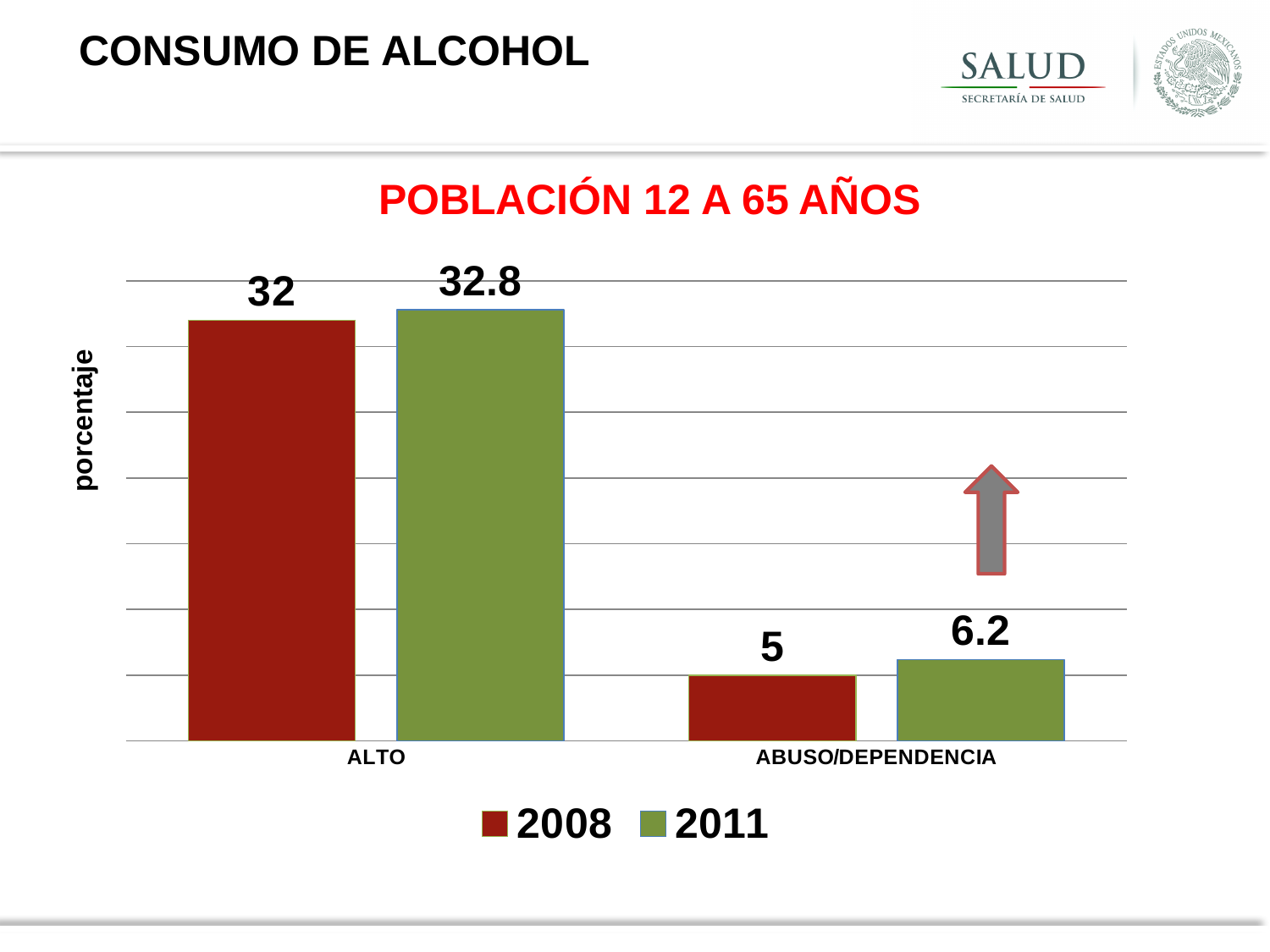
How many categories are shown on the x axis? 2 What is the value for ABUSO/DEPENDENCIA in 2011? 6.2 Which category has the highest value in 2011? ALTO Which category has the lowest value in 2008? ABUSO/DEPENDENCIA What is the difference between the 2011 and 2008 values for ABUSO/DEPENDENCIA? 1.2 Which is larger for ALTO, the 2008 value or the 2011 value? 2011 What kind of chart is shown on the slide? Bar chart What is the value for ALTO in 2008? 32 How many series does the legend list? 2 What is the difference between the 2011 and 2008 values for ALTO? 0.8 What is the value for ABUSO/DEPENDENCIA in 2008? 5 What is the value for ALTO in 2011? 32.8